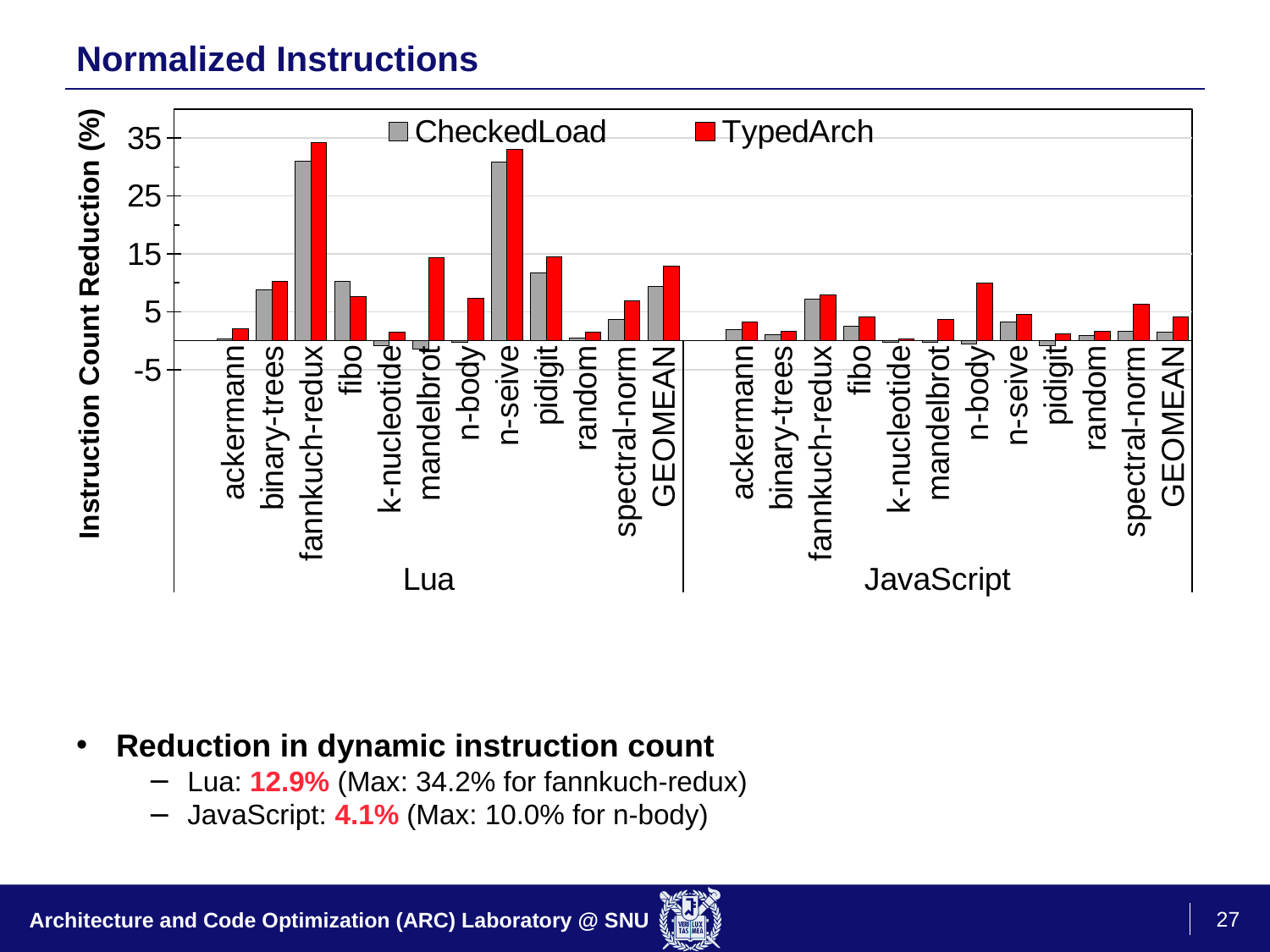
What is the maximum TypedArch instruction count reduction for JavaScript, as stated on the slide? 10.0% How many benchmark categories (including GEOMEAN) are plotted in the Lua group? 12 Is the TypedArch value for n-seive in the Lua group greater or less than 25? greater What kind of chart is shown on the slide? bar chart What is the label on the vertical axis of the chart? Instruction Count Reduction (%) Which JavaScript benchmark has the highest TypedArch instruction count reduction? n-body How many series does the chart legend list? 2 For fibo in the Lua group, which series has the larger value, CheckedLoad or TypedArch? CheckedLoad What are the two series named in the chart legend? CheckedLoad and TypedArch Is the TypedArch value for n-body in the JavaScript group greater or less than 5? greater Which Lua benchmark has the highest TypedArch instruction count reduction? fannkuch-redux What is the maximum TypedArch instruction count reduction for Lua, as stated on the slide? 34.2%